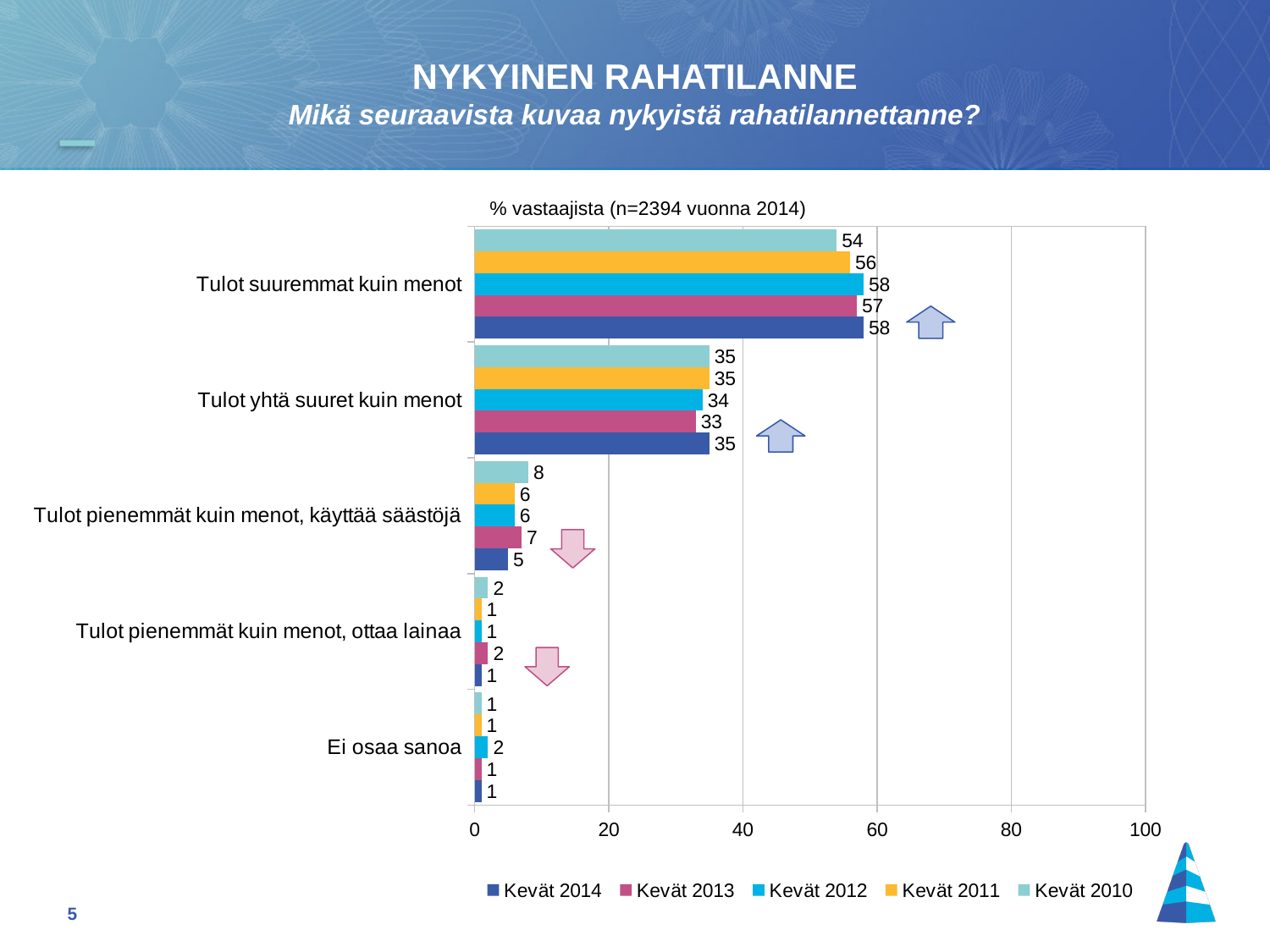
What is the value for "Tulot suuremmat kuin menot" in the Kevät 2014 series? 58 How many series does the legend list? 5 Which category has the highest value in the Kevät 2014 series? Tulot suuremmat kuin menot What is the value for "Ei osaa sanoa" in the Kevät 2012 series? 2 What is the difference between the Kevät 2014 and Kevät 2010 values for "Tulot suuremmat kuin menot"? 4 How many categories are shown on the chart? 5 What is the value for "Tulot yhtä suuret kuin menot" in the Kevät 2013 series? 33 What is the title printed above the chart's plot area? % vastaajista (n=2394 vuonna 2014) Is the Kevät 2012 value for "Tulot suuremmat kuin menot" greater or less than 40? greater What kind of chart is shown on the slide? Bar chart For "Tulot pienemmät kuin menot, käyttää säästöjä", which is larger: the Kevät 2013 value or the Kevät 2014 value? Kevät 2013 What is the value for "Tulot pienemmät kuin menot, käyttää säästöjä" in the Kevät 2010 series? 8